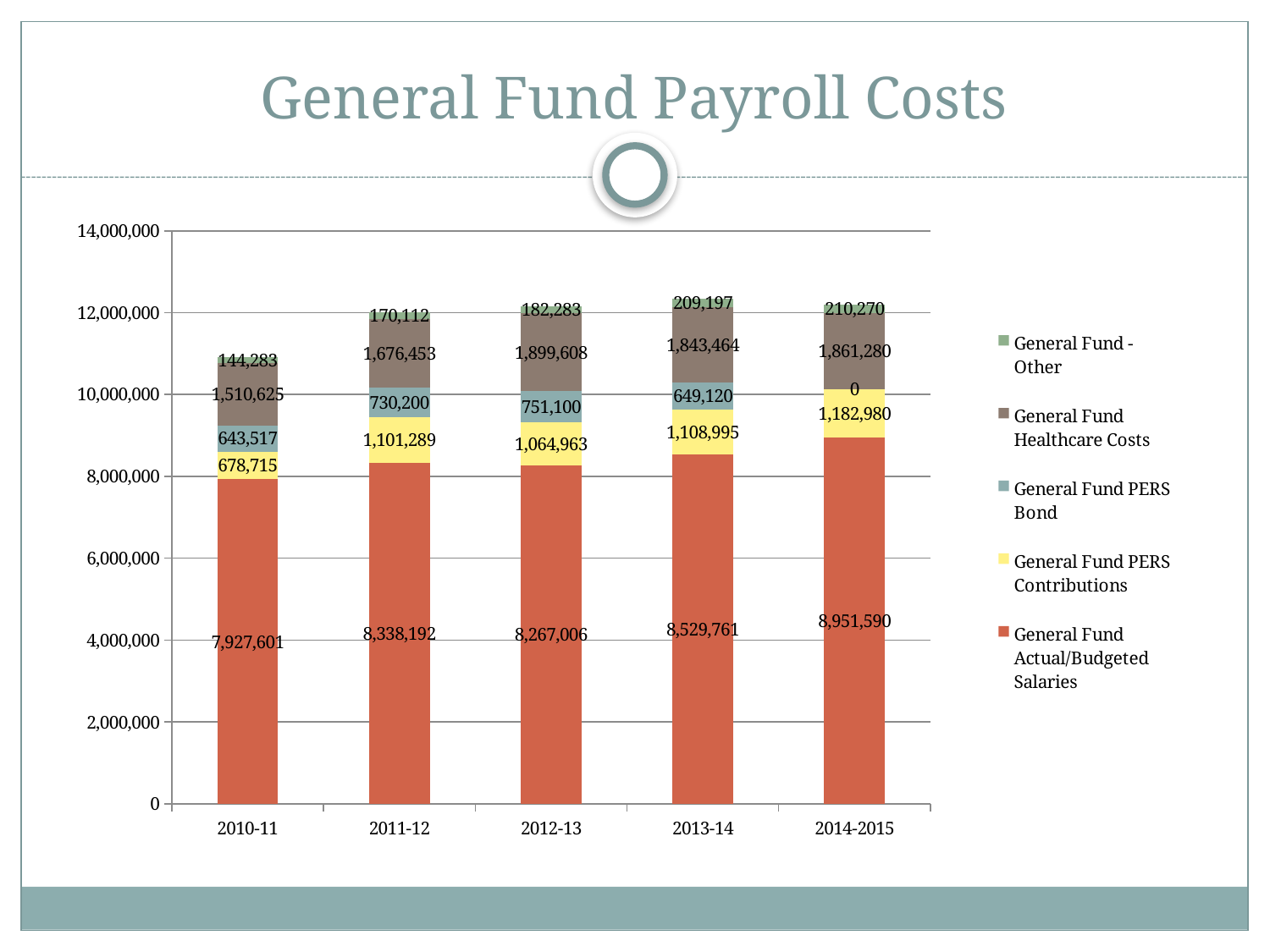
What is the value of General Fund Healthcare Costs for 2012-13? 1,899,608 What is the difference in General Fund Actual/Budgeted Salaries between 2014-2015 and 2010-11? 1,023,989 What type of chart is shown on the slide? Stacked bar chart How many series does the legend list? 5 Which year has the highest General Fund Actual/Budgeted Salaries? 2014-2015 What is the title of the chart? General Fund Payroll Costs What is the value of General Fund Actual/Budgeted Salaries for 2010-11? 7,927,601 Which is larger: General Fund PERS Contributions in 2011-12 or in 2012-13? 2011-12 What is the total of the stacked bar for 2010-11? 10,904,741 Which year has the lowest General Fund Healthcare Costs? 2010-11 How many fiscal years are shown on the x axis? 5 What is the value of General Fund PERS Bond for 2014-2015? 0